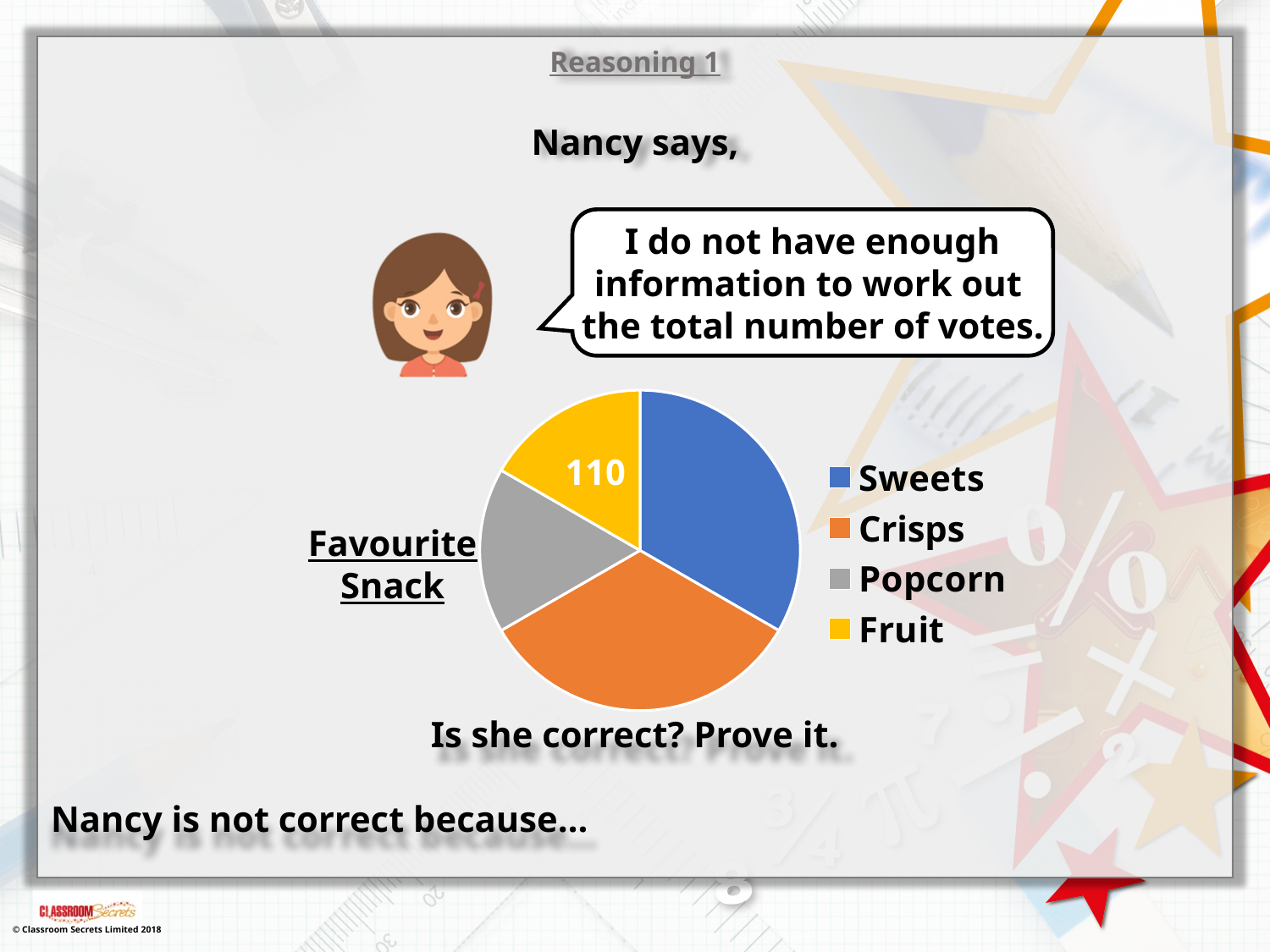
What kind of chart is shown on the slide? pie chart What value is printed on the Fruit slice of the Favourite Snack pie chart? 110 Which category's slice carries the only data label in the pie chart? Fruit Which colour represents Sweets in the pie chart? blue Which slice is larger in the pie chart, Crisps or Popcorn? Crisps How many categories does the Favourite Snack pie chart show? 4 What is the title of the pie chart? Favourite Snack Which slice is larger in the pie chart, Sweets or Fruit? Sweets How many entries does the legend of the pie chart list? 4